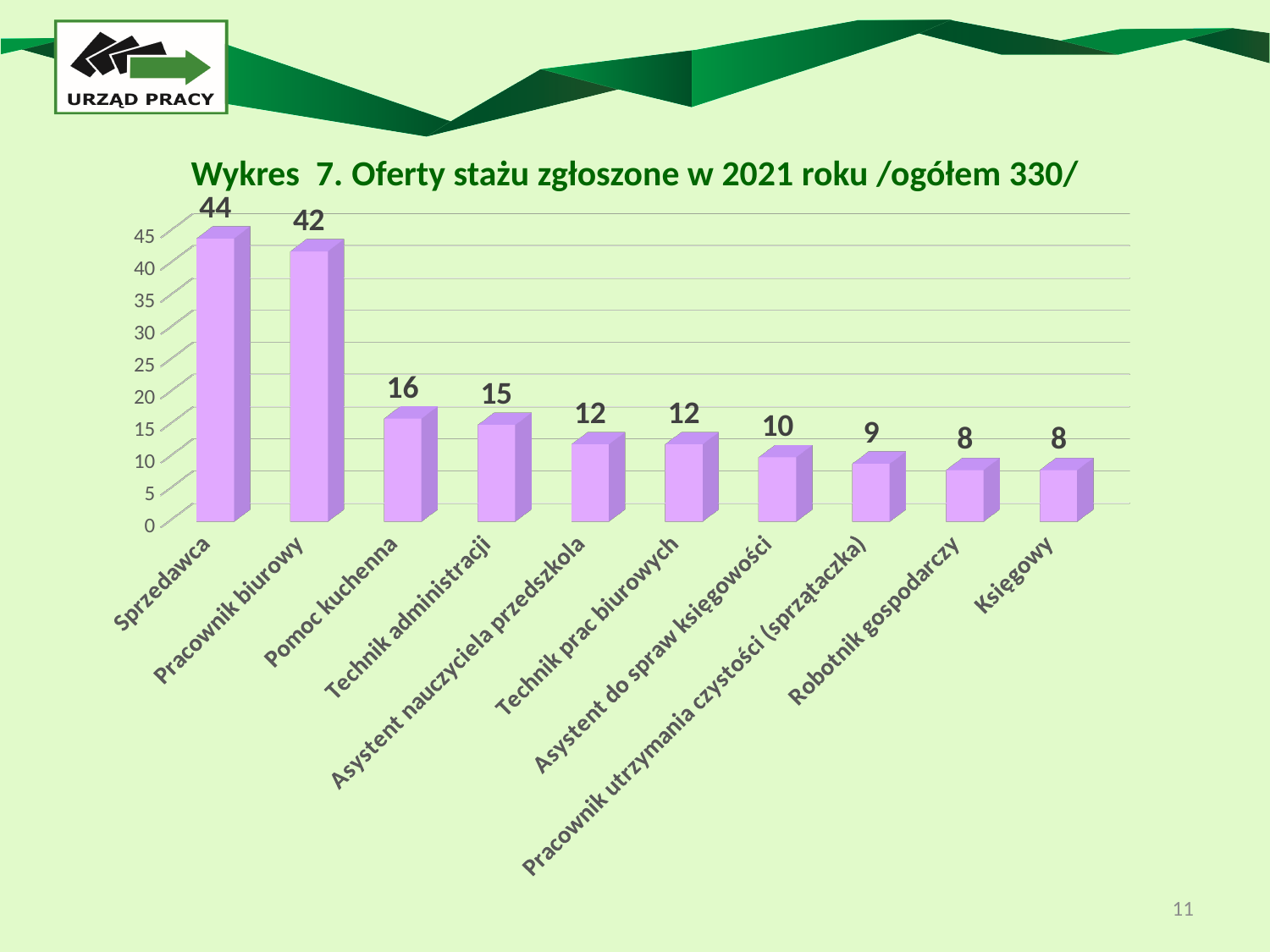
What is the value for Księgowy? 8 What is the difference between the values for Pomoc kuchenna and Technik administracji? 1 What kind of chart is shown on the slide? bar chart How many categories are shown on the chart? 10 Which is larger, the value for Technik administracji or the value for Asystent do spraw księgowości? Technik administracji Which category has the highest value? Sprzedawca What is the value for Asystent do spraw księgowości? 10 What is the value for Sprzedawca? 44 What is the value for Pomoc kuchenna? 16 What is the title of the chart? Wykres 7. Oferty stażu zgłoszone w 2021 roku /ogółem 330/ Do the values rise or fall from left to right along the x axis? fall What is the difference between the values for Sprzedawca and Pracownik biurowy? 2